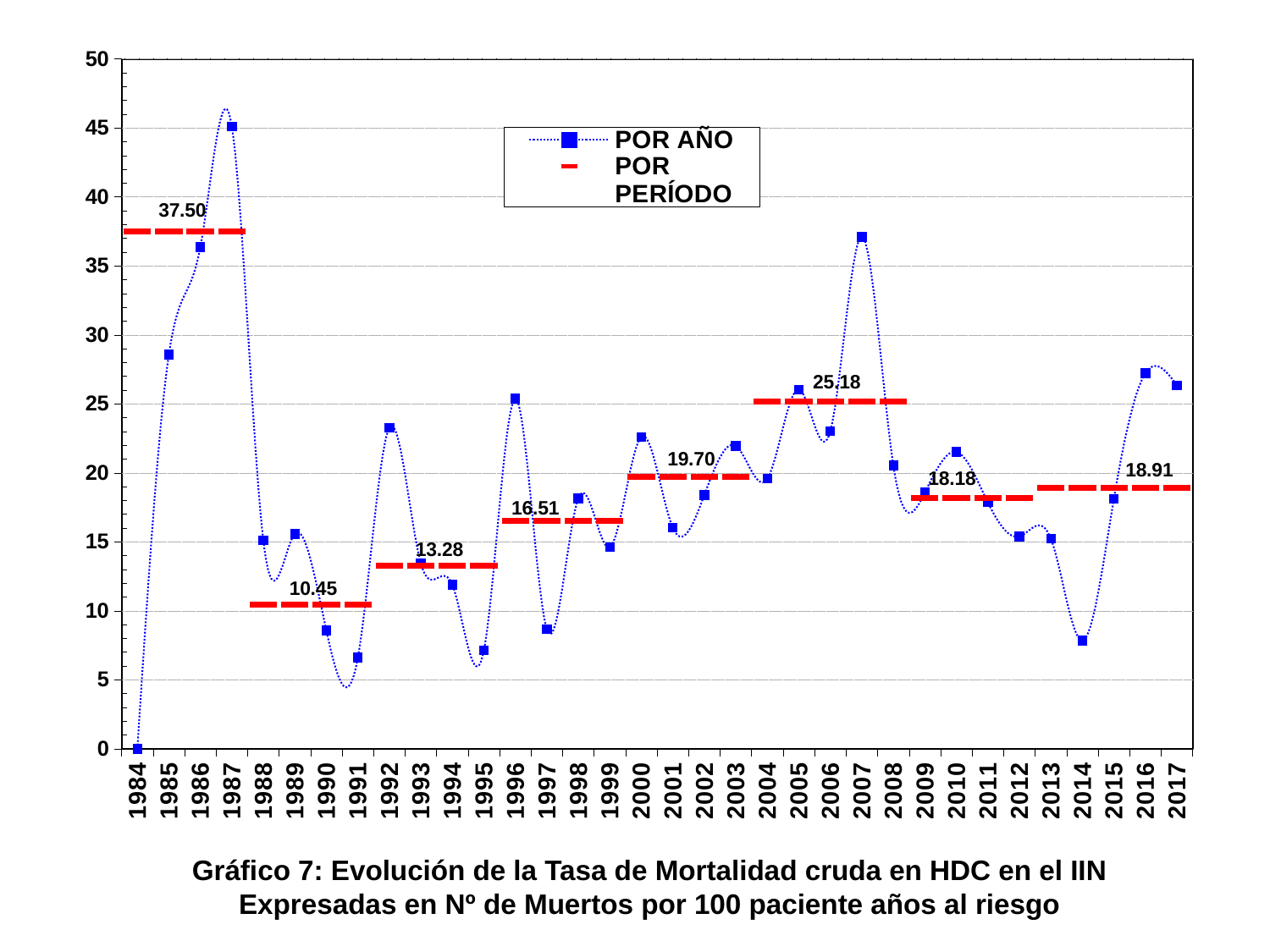
What is the POR PERÍODO value for the period covering 1984 to 1987? 37.50 How many series does the legend list? 2 What kind of chart is shown on the slide? line chart Which is larger, the POR PERÍODO value for 1996-1999 or for 1992-1995? 1996-1999 (16.51) Is the POR AÑO value for 1987 greater or less than 40? greater What is the difference between the POR PERÍODO values 25.18 and 19.70? 5.48 What is the POR PERÍODO value for the period covering 2013 to 2017? 18.91 How many years are plotted on the x axis? 34 Which period has the lowest POR PERÍODO value? 1988-1991 (10.45) Is the POR AÑO value for 2014 greater or less than 10? less Which period has the highest POR PERÍODO value? 1984-1987 (37.50) What is the POR PERÍODO value for the period covering 2004 to 2008? 25.18